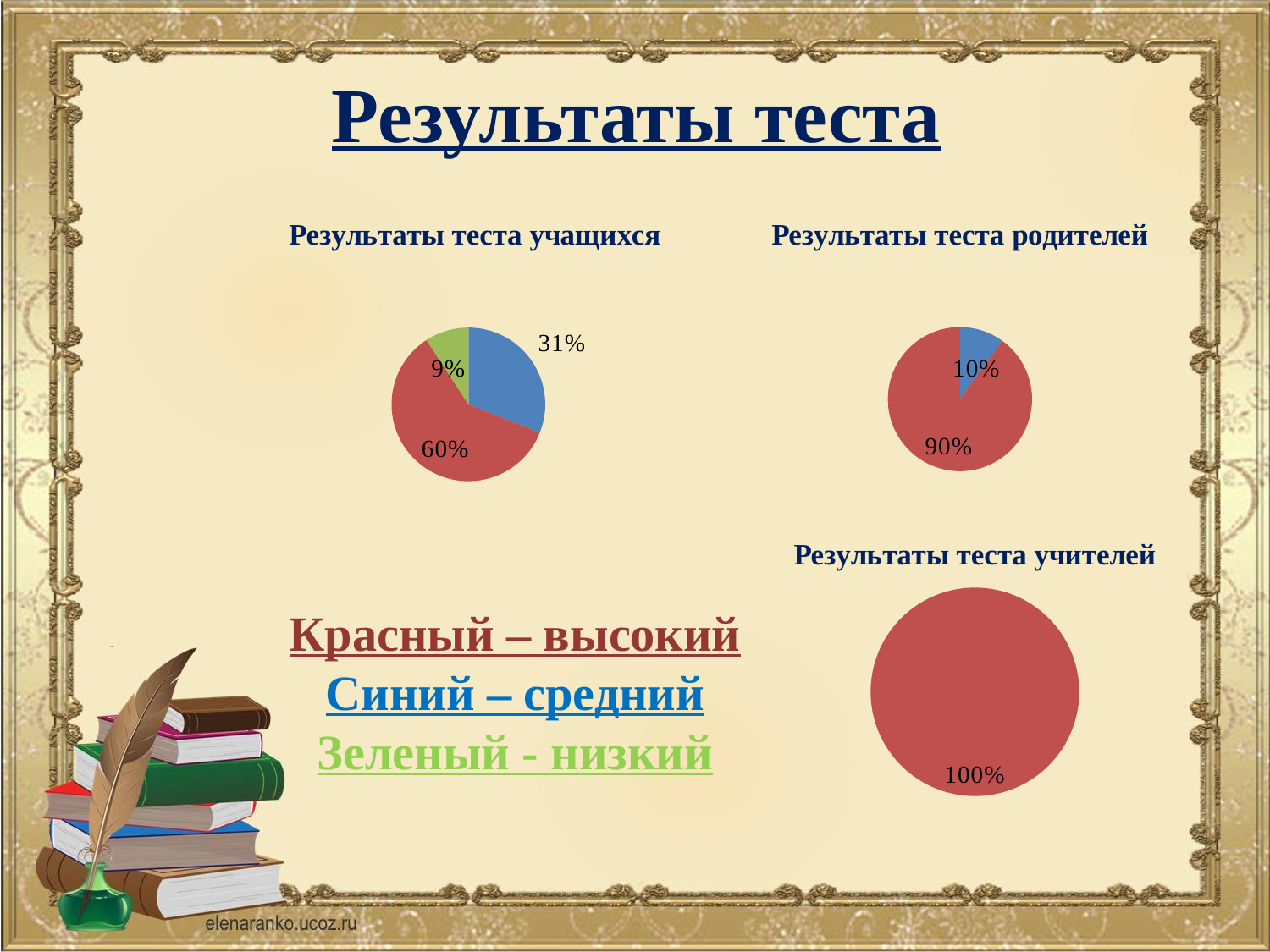
In the "Результаты теста родителей" chart, what share does the blue (средний) slice have? 10% In the "Результаты теста учащихся" chart, what share does the red (высокий) slice have? 60% In the "Результаты теста родителей" chart, what share does the red (высокий) slice have? 90% What kind of chart is "Результаты теста учащихся"? pie chart In the "Результаты теста учителей" chart, what share does the red (высокий) slice have? 100% How many slices does the "Результаты теста учащихся" pie chart have? 3 In the "Результаты теста учащихся" chart, which slice is the smallest? green (низкий), 9% In the "Результаты теста учащихся" chart, what share does the blue (средний) slice have? 31% In the "Результаты теста учащихся" chart, what share does the green (низкий) slice have? 9% According to the slide's colour key, which level does the green colour represent? низкий In the "Результаты теста учащихся" chart, which slice is the largest? red (высокий), 60% In the "Результаты теста учащихся" chart, what is the difference between the red slice and the blue slice? 29%